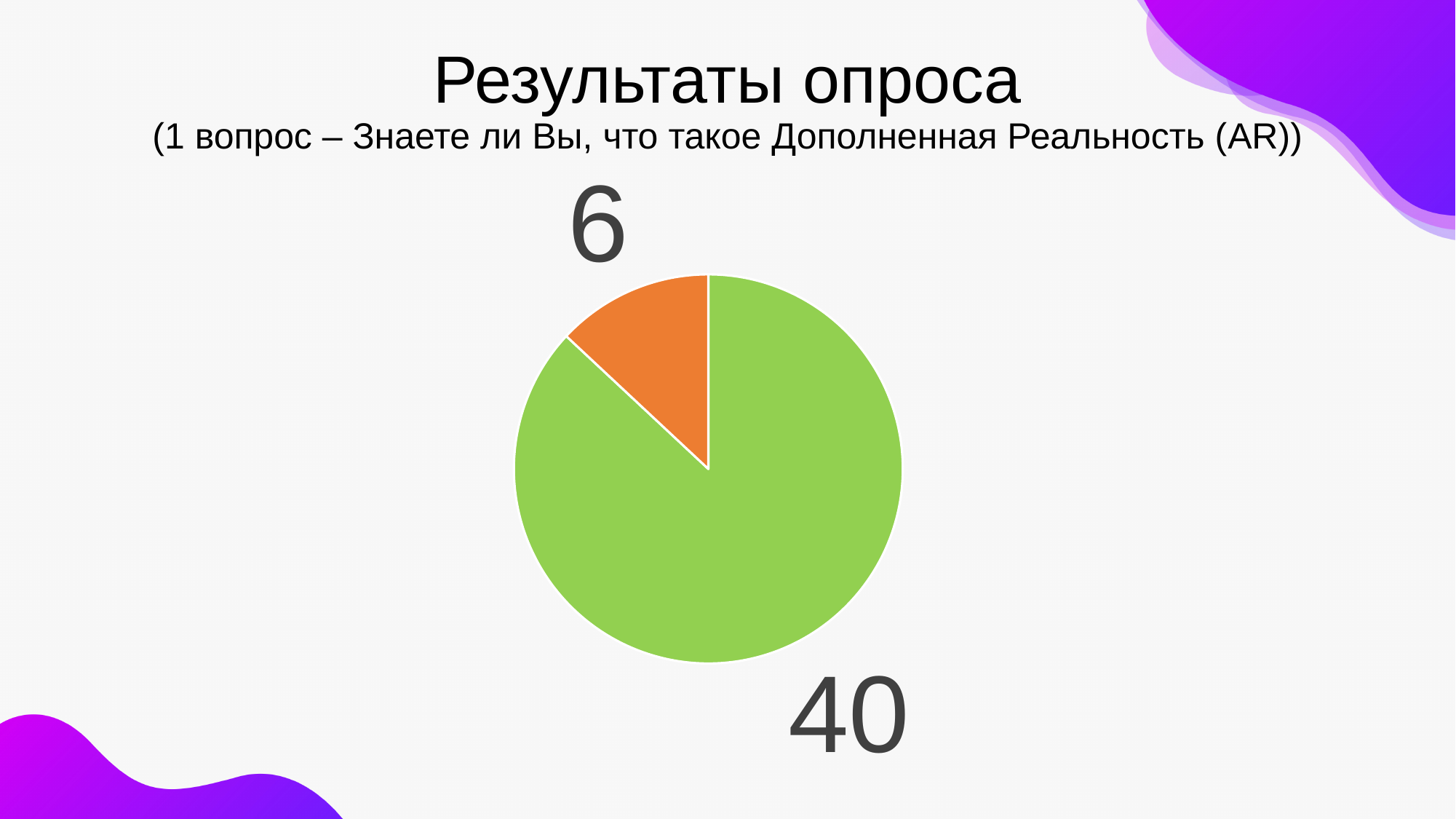
Which is larger, the green slice or the orange slice? the green slice What survey question does the subtitle say the pie chart refers to? Знаете ли Вы, что такое Дополненная Реальность (AR) What type of chart is shown on the slide? pie chart Which slice of the pie chart has the largest value? the green slice (40) What is the difference between the green slice and the orange slice values? 34 What is the value of the orange slice of the pie chart? 6 What is the value of the green slice of the pie chart? 40 Which slice of the pie chart has the smallest value? the orange slice (6) What is the title of the slide containing the pie chart? Результаты опроса What is the sum of the two values shown on the pie chart? 46 How many slices does the pie chart have? 2